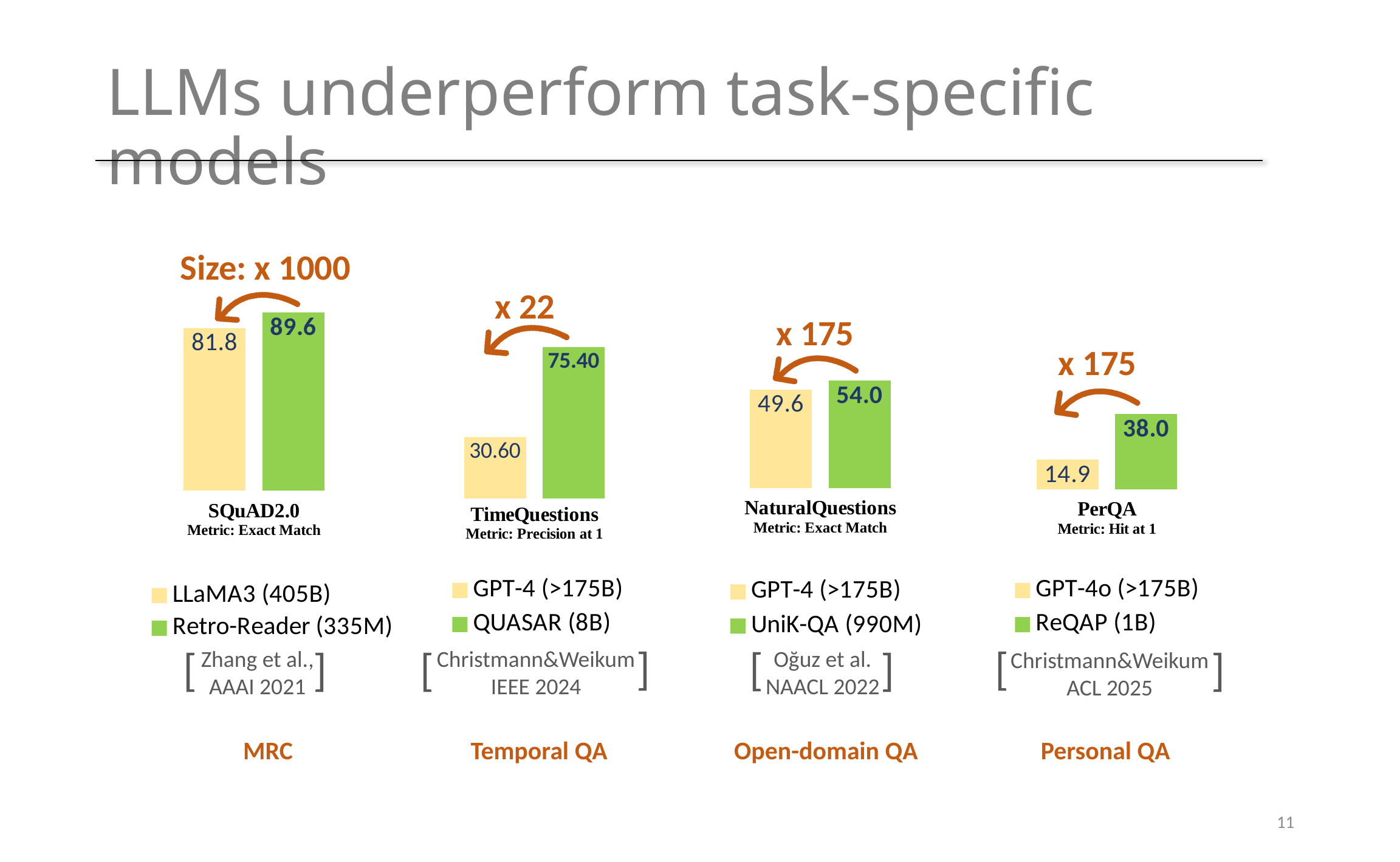
In the PerQA chart, what is the value for GPT-4o (>175B)? 14.9 In the TimeQuestions chart, which is larger, the value for GPT-4 (>175B) or the value for QUASAR (8B)? QUASAR (8B) In the NaturalQuestions chart, what is the value for UniK-QA (990M)? 54.0 In the TimeQuestions chart, what is the value for QUASAR (8B)? 75.40 In the SQuAD2.0 chart, what is the value for LLaMA3 (405B)? 81.8 In the SQuAD2.0 chart, what is the value for Retro-Reader (335M)? 89.6 In the TimeQuestions chart, what is the value for GPT-4 (>175B)? 30.60 What kind of chart is the SQuAD2.0 chart? bar chart What metric is stated under the PerQA chart? Hit at 1 In the NaturalQuestions chart, what is the difference between the UniK-QA (990M) value and the GPT-4 (>175B) value? 4.4 In the PerQA chart, what is the difference between the ReQAP (1B) value and the GPT-4o (>175B) value? 23.1 How many series does the legend of the NaturalQuestions chart list? 2